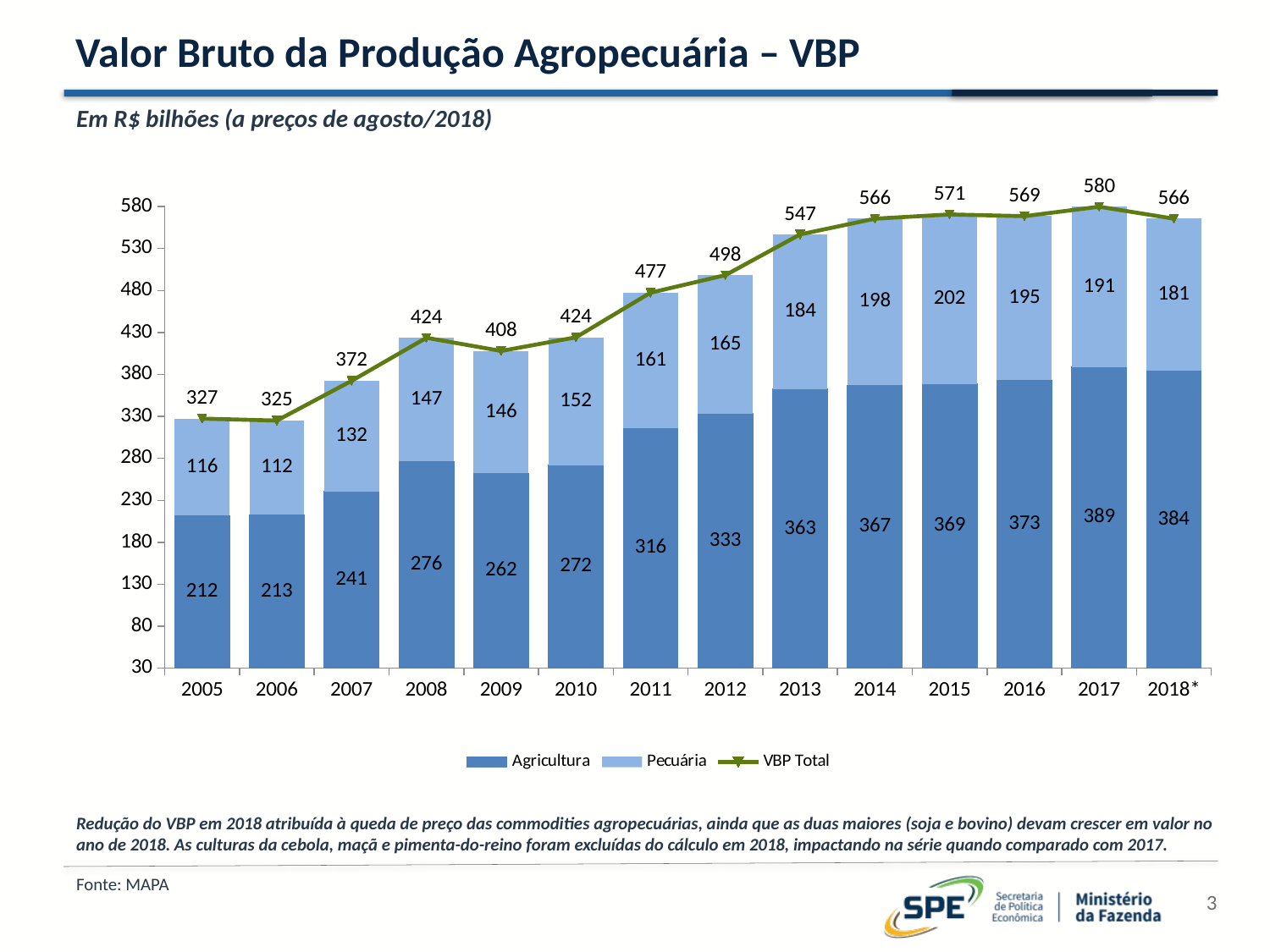
In which year is the Pecuária value highest? 2015 How many series does the legend list? 3 What is the VBP Total value for 2013? 547 What is the Agricultura value for 2012? 333 How many years are shown on the x axis? 14 What kind of chart is this? Stacked bar chart with a line Which is larger, the Pecuária value for 2014 or for 2016? 2014 In which year is the Agricultura value lowest? 2005 What is the difference between the Agricultura values for 2017 and 2018*? 5 What is the Pecuária value for 2008? 147 In which year is the VBP Total highest? 2017 Does the VBP Total generally rise or fall from 2005 to 2017? Rise